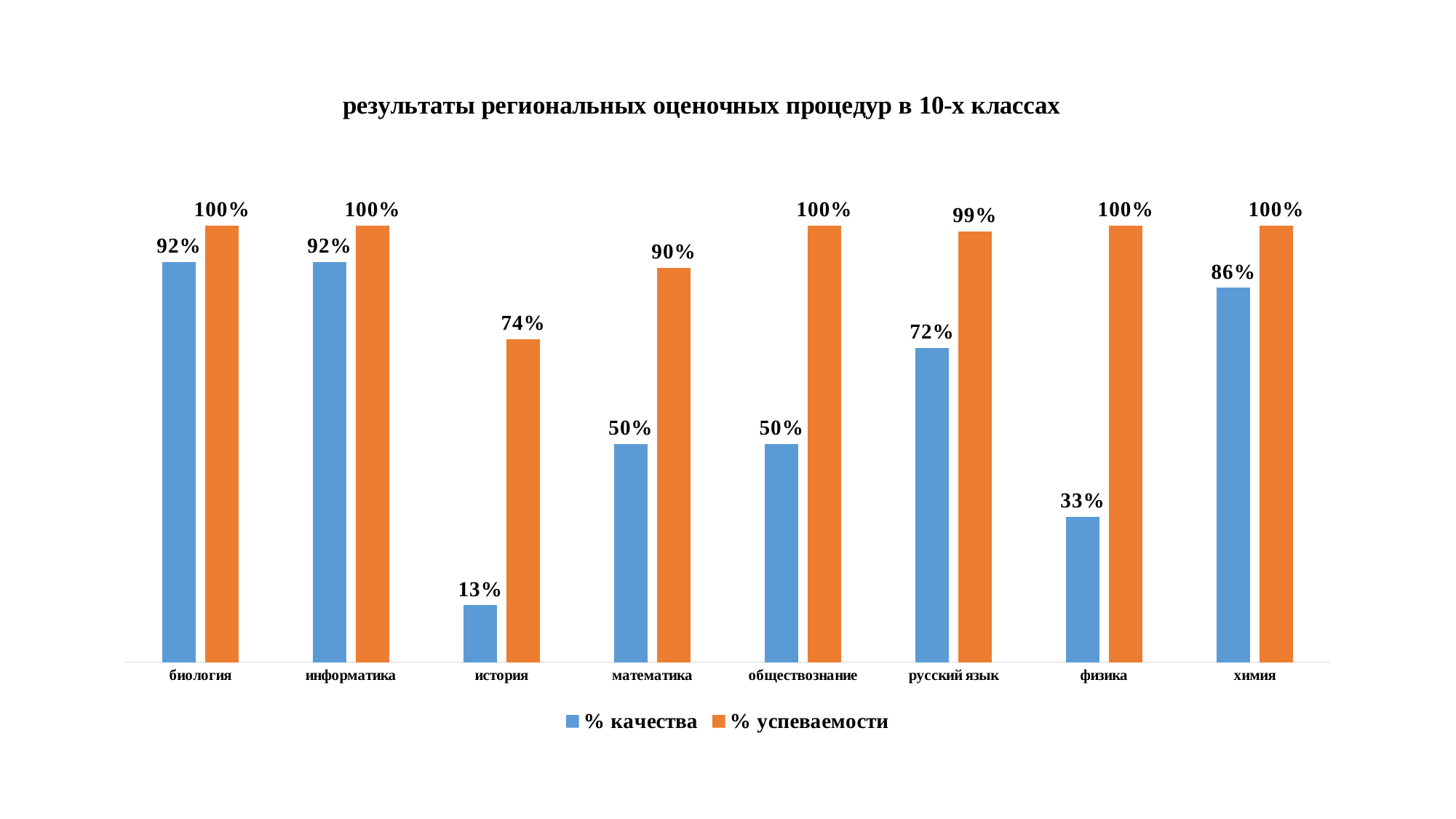
What is the % качества value for история? 13% Which category has the lowest % успеваемости value? история What is the % успеваемости value for русский язык? 99% What type of chart is shown on the slide? bar chart What is the % качества value for физика? 33% How many series does the legend list? 2 What is the difference between the % качества values for химия and русский язык? 14% What is the difference between % успеваемости and % качества for физика? 67% What is the % успеваемости value for математика? 90% How many categories are shown on the x axis? 8 Which category has the lowest % качества value? история Which is larger: the % качества value for химия or for русский язык? химия